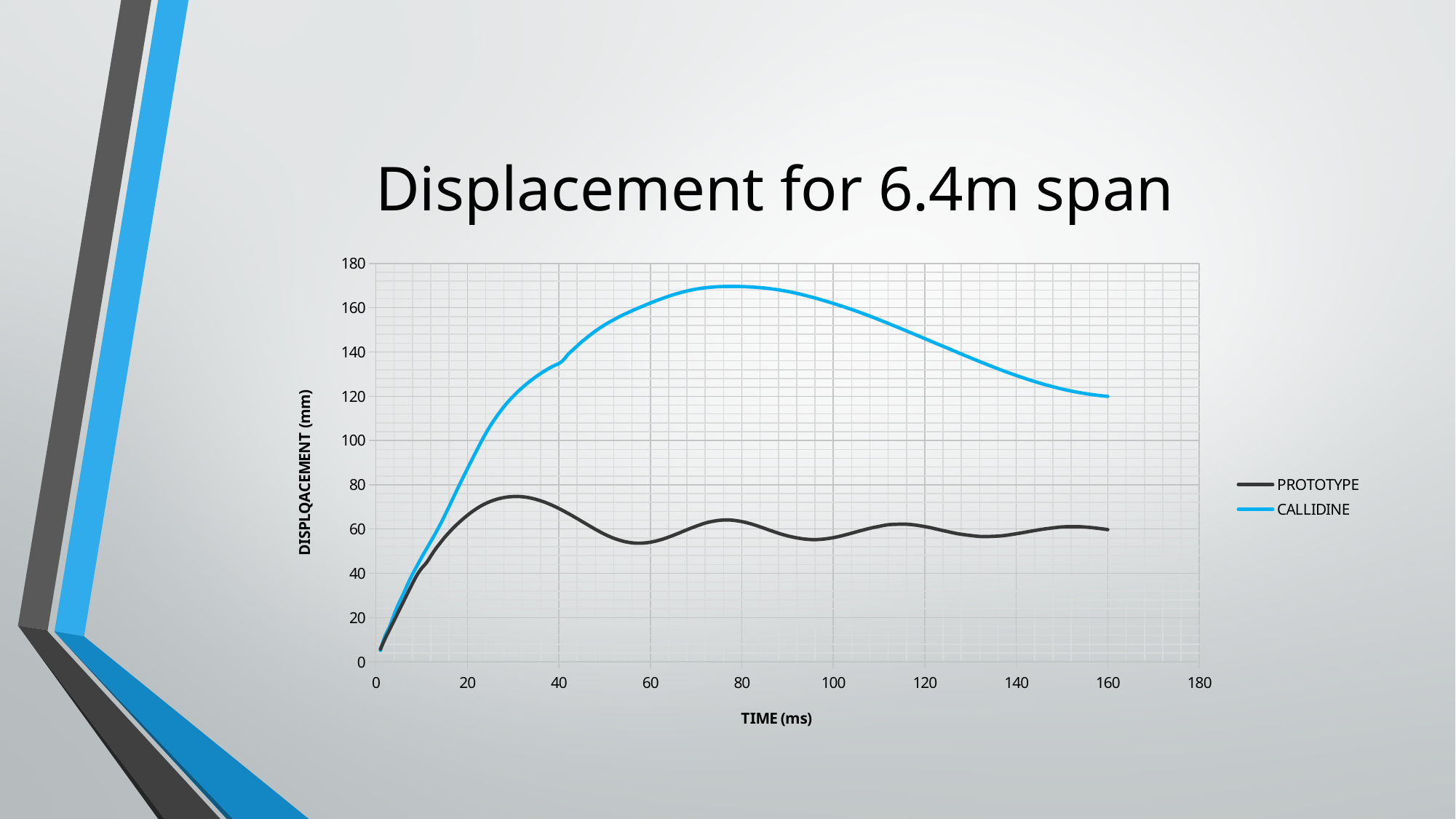
Is the CALLIDINE value at 40 ms greater or less than 140? less Is the PROTOTYPE value at 30 ms greater or less than 80? less Is the CALLIDINE value at 80 ms greater or less than 160? greater At 100 ms, which series has the larger displacement, PROTOTYPE or CALLIDINE? CALLIDINE What is the title of the chart? Displacement for 6.4m span Does the CALLIDINE line rise or fall between 80 ms and 160 ms? fall What kind of chart is shown on the slide? line chart How many series does the legend list? 2 What is the label of the x axis? TIME (ms) Which series reaches the highest displacement on the chart? CALLIDINE